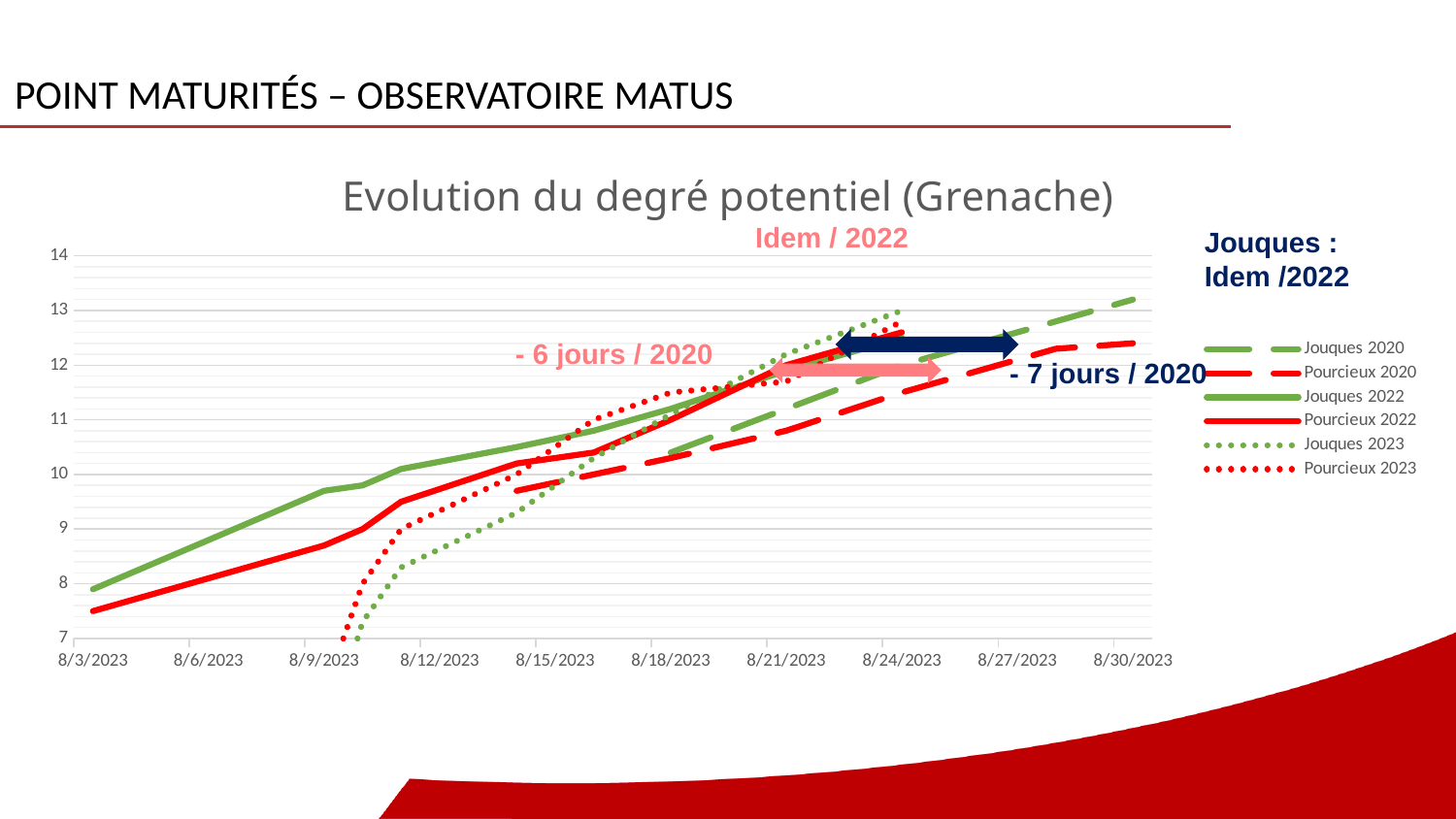
Is the value for Pourcieux 2022 on 8/9/2023 greater or less than 9? less Is the value for Pourcieux 2022 on 8/3/2023 greater or less than 8? less Do the values of the Jouques 2022 series rise or fall along the x axis? rise How many date labels are shown on the x axis? 10 Which series reaches the highest value on 8/30/2023? Jouques 2020 How many series does the chart legend list? 6 What kind of chart is shown on the slide? line chart Is the value for Jouques 2022 on 8/9/2023 greater or less than 9? greater On 8/3/2023, which series has the higher value, Jouques 2022 or Pourcieux 2022? Jouques 2022 What is the title of the chart? Evolution du degré potentiel (Grenache)